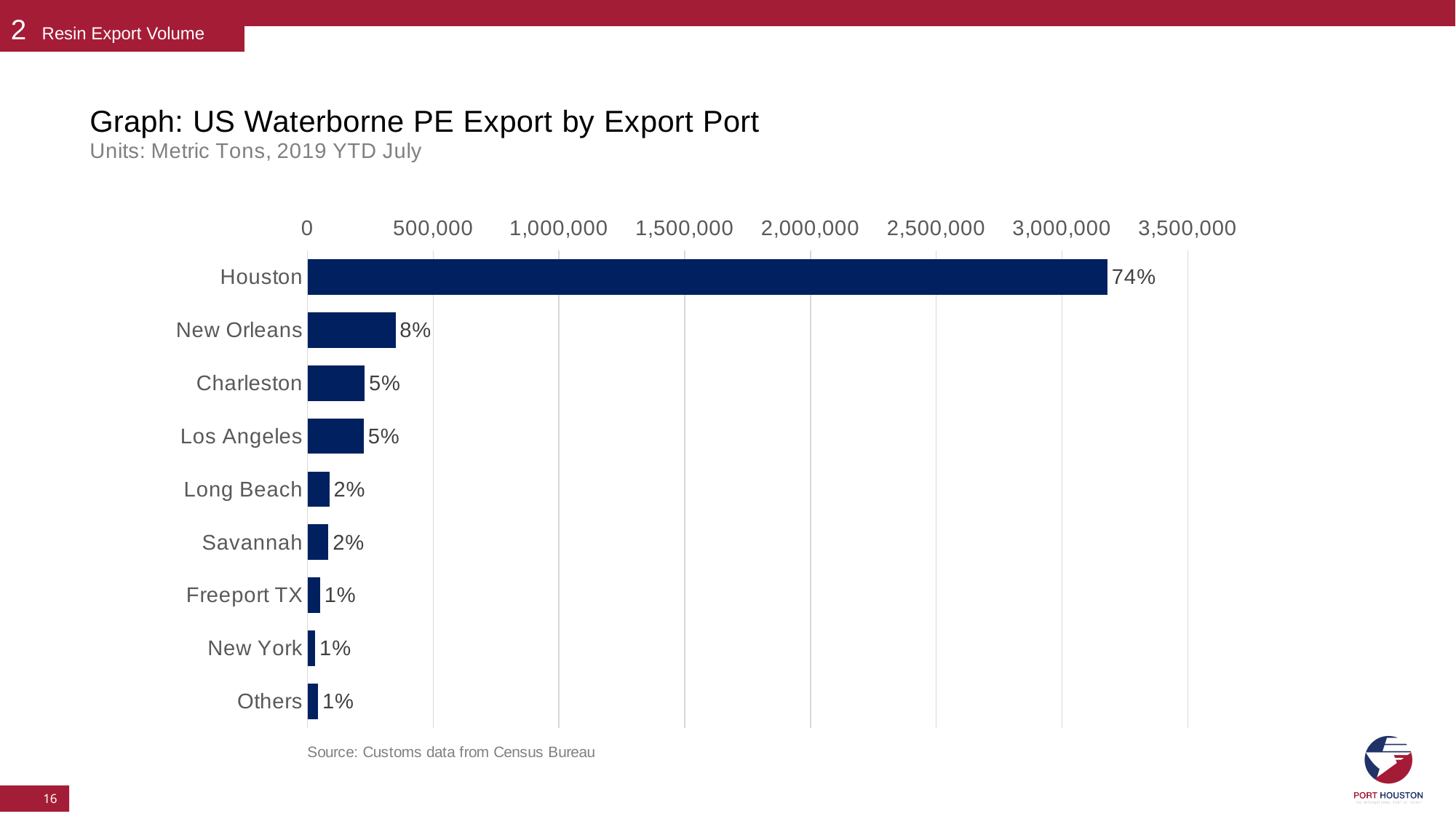
What percentage label is shown for Houston? 74% How many ports (categories) are shown in the chart? 9 What is the source cited below the chart? Customs data from Census Bureau What percentage label is shown for New Orleans? 8% Which has a larger export volume, New Orleans or Charleston? New Orleans Is the value for Houston greater or less than 3,000,000? greater Which port has the highest export volume in the chart? Houston What kind of chart is shown on the slide? Bar chart What is the difference in percentage points between Houston's share and New Orleans' share? 66 percentage points What units and period does the chart subtitle state? Metric Tons, 2019 YTD July What percentage label is shown for Long Beach? 2% Is the value for New Orleans greater or less than 500,000? less